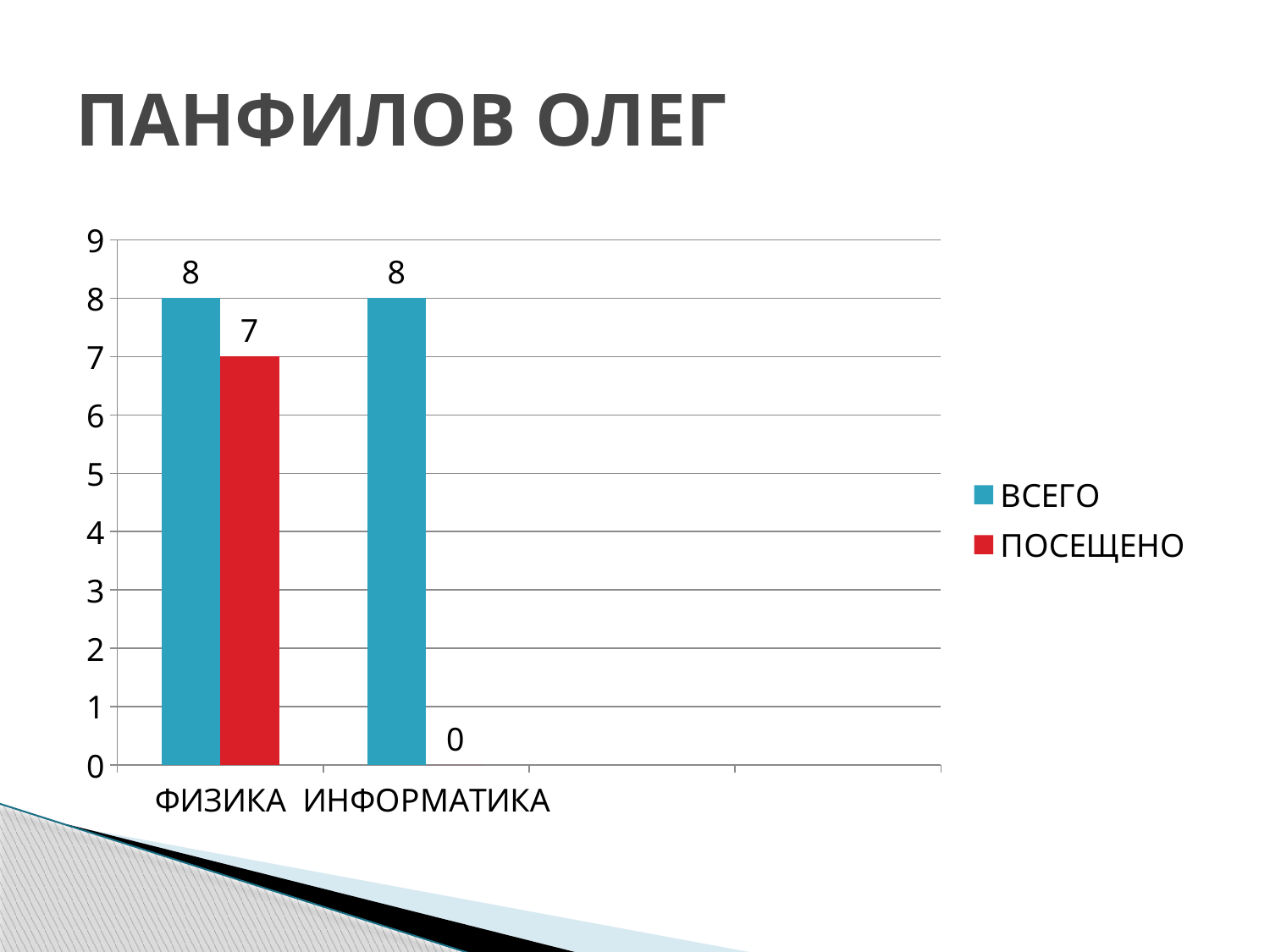
What is the ПОСЕЩЕНО value for ФИЗИКА? 7 What is the ВСЕГО value for ИНФОРМАТИКА? 8 How many series does the legend list? 2 What is the ВСЕГО value for ФИЗИКА? 8 What is the title of the slide? ПАНФИЛОВ ОЛЕГ Which category has the lowest ПОСЕЩЕНО value? ИНФОРМАТИКА What is the ПОСЕЩЕНО value for ИНФОРМАТИКА? 0 Which category has the highest ПОСЕЩЕНО value? ФИЗИКА What is the difference between ВСЕГО and ПОСЕЩЕНО for ИНФОРМАТИКА? 8 What is the difference between ВСЕГО and ПОСЕЩЕНО for ФИЗИКА? 1 Which is larger for ФИЗИКА, ВСЕГО or ПОСЕЩЕНО? ВСЕГО What kind of chart is shown on the slide? Bar chart